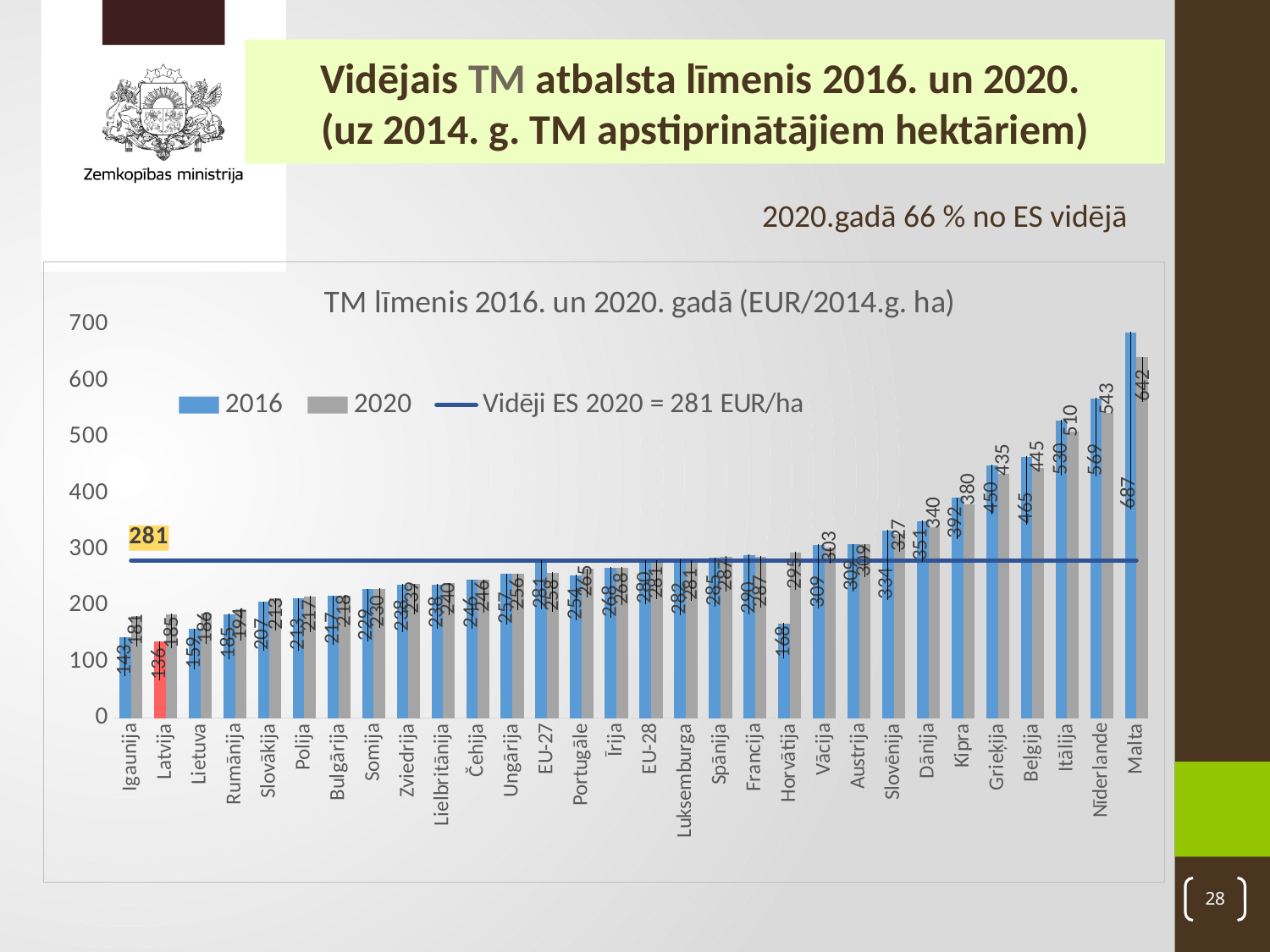
What is the 2020 value for Itālija? 510 Which category has the lowest 2016 value? Latvija Which category has the highest 2020 value? Malta How many countries/categories are shown on the x axis of the chart? 30 How many entries does the chart legend list? 3 What is the 2020 value for Malta? 642 Is the 2016 value for Nīderlande greater or less than 500? greater What is the 2016 value for Latvija? 136 What value does the horizontal line for the EU 2020 average represent, according to the legend? 281 EUR/ha What is the difference between the 2016 and 2020 values for Malta? 45 For Horvātija, which is larger: the 2016 value or the 2020 value? 2020 What kind of chart is shown on the slide? bar chart